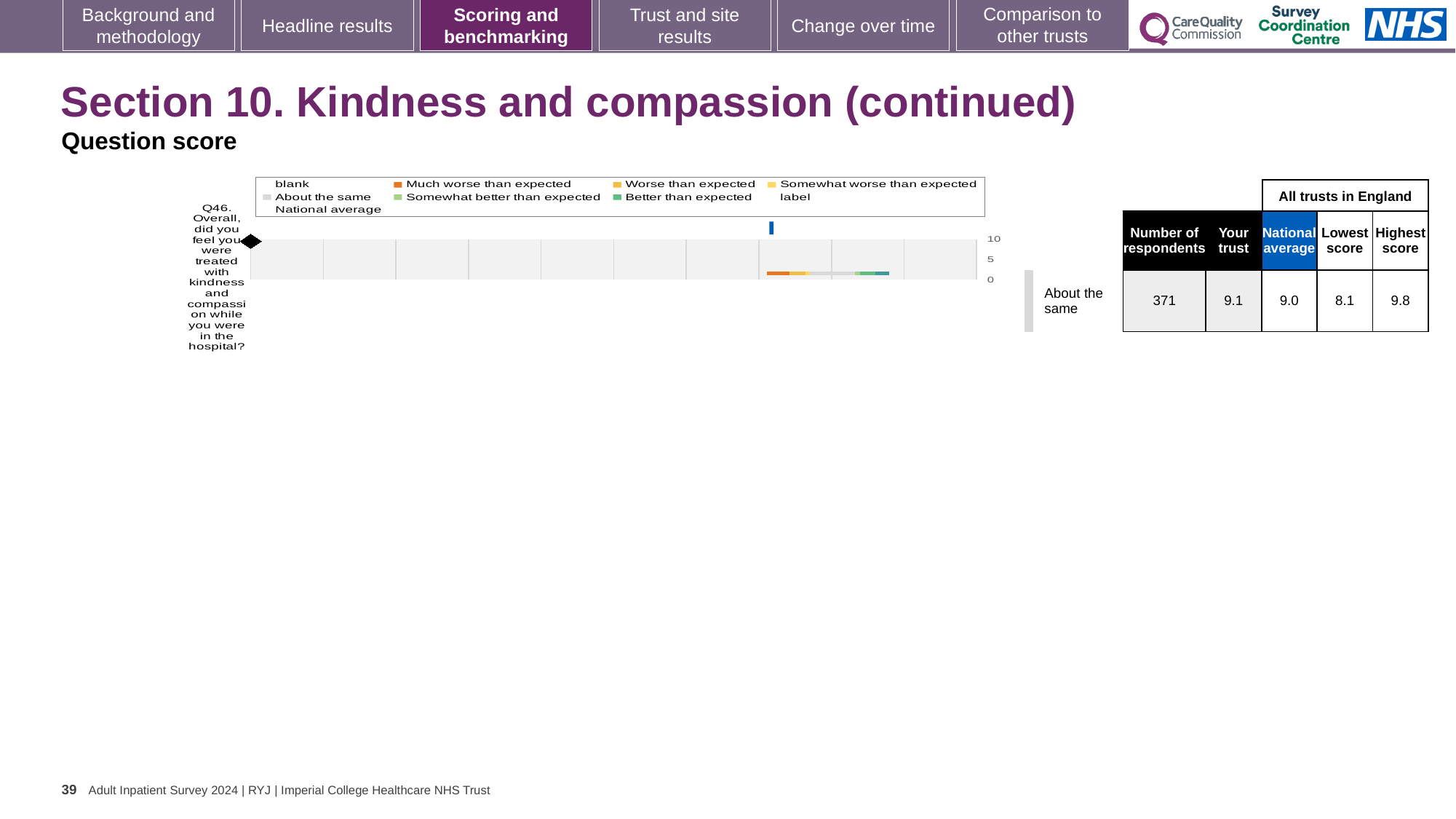
What is the lowest score among all trusts in England for Q46? 8.1 What is the highest score among all trusts in England for Q46? 9.8 What is the 'Your trust' score for Q46 (treated with kindness and compassion)? 9.1 How many survey questions are plotted on the chart? 1 Which is higher for Q46: the 'Your trust' score or the national average? Your trust What is the national average score for Q46? 9.0 What is the difference between the highest and lowest scores for Q46 across all trusts in England? 1.7 How many respondents answered Q46? 371 What benchmark category is shown for Q46 next to the chart? About the same By how much does the 'Your trust' score for Q46 exceed the national average? 0.1 What is the highest value shown on the chart's score axis? 10 What kind of chart is used to show the Q46 question score? Bar chart